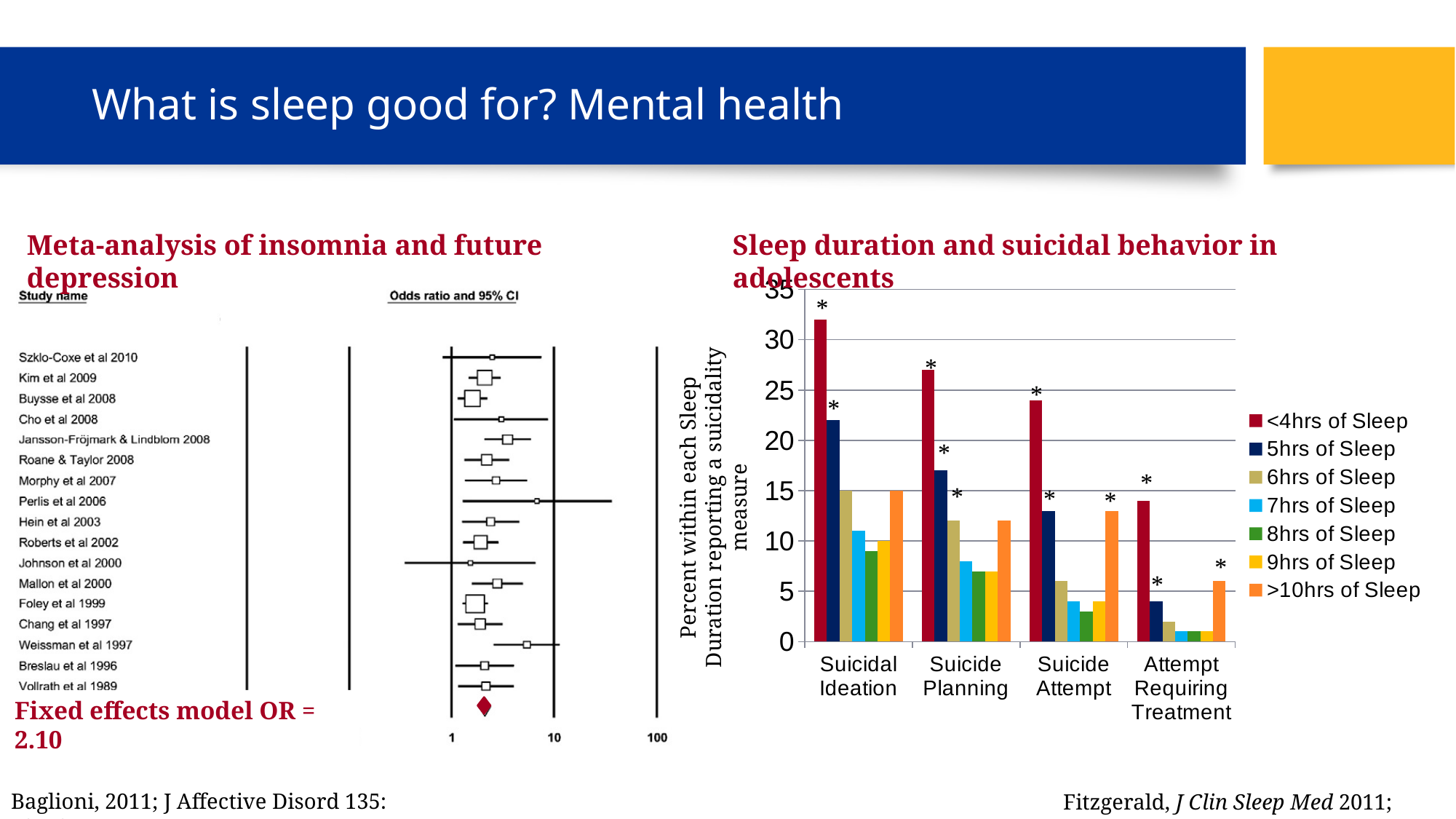
In the 'Sleep duration and suicidal behavior in adolescents' chart, which sleep duration series has the highest bar in the Suicidal Ideation category? <4hrs of Sleep In the 'Meta-analysis of insomnia and future depression' forest plot on the left, how many studies are listed? 17 What kind of chart is the 'Sleep duration and suicidal behavior in adolescents' chart on the right? bar chart How many categories are shown on the x axis of the 'Sleep duration and suicidal behavior in adolescents' chart? 4 In the 'Sleep duration and suicidal behavior in adolescents' chart, in which category is the '<4hrs of Sleep' bar lowest? Attempt Requiring Treatment In the 'Sleep duration and suicidal behavior in adolescents' chart, is the value for '<4hrs of Sleep' in the Suicidal Ideation category greater or less than 30? greater In the 'Sleep duration and suicidal behavior in adolescents' chart, which is larger in the Suicide Attempt category: '<4hrs of Sleep' or '5hrs of Sleep'? <4hrs of Sleep In the 'Meta-analysis of insomnia and future depression' forest plot on the left, what is the fixed effects model odds ratio stated on the slide? 2.10 In the 'Sleep duration and suicidal behavior in adolescents' chart, is the value for '5hrs of Sleep' in the Suicidal Ideation category greater or less than 20? greater In the 'Sleep duration and suicidal behavior in adolescents' chart, is the value for '<4hrs of Sleep' in the Suicide Planning category greater or less than 25? greater How many series does the legend of the 'Sleep duration and suicidal behavior in adolescents' chart list? 7